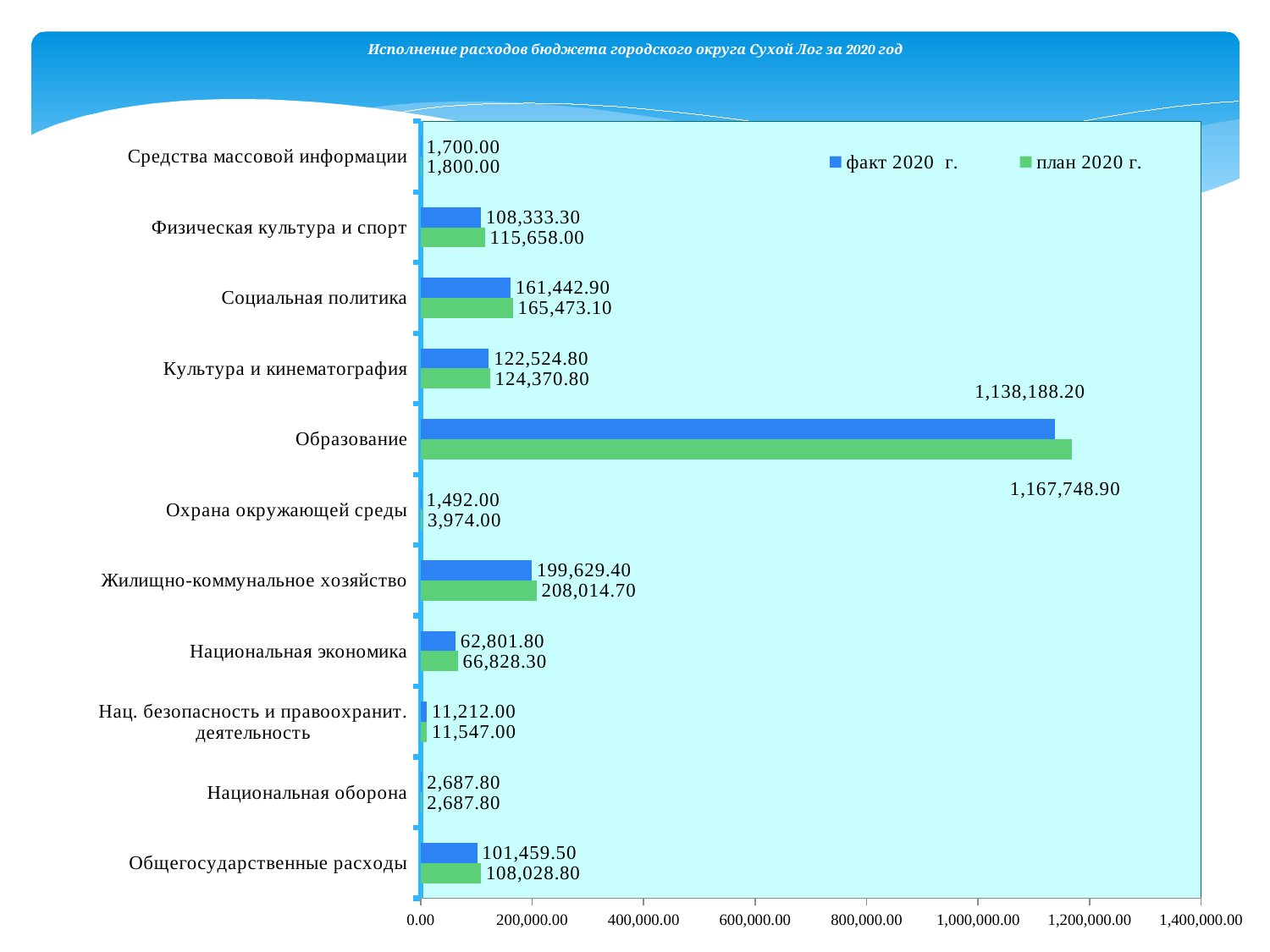
How many categories are shown on the chart? 11 What is the факт 2020 г. value for Национальная оборона? 2,687.80 Is the план 2020 г. value for Образование greater or less than 1,000,000.00? greater What is the difference between the план 2020 г. and факт 2020 г. values for Общегосударственные расходы? 6,569.30 Which category has the highest факт 2020 г. value? Образование Which category has the lowest план 2020 г. value? Средства массовой информации What is the план 2020 г. value for Жилищно-коммунальное хозяйство? 208,014.70 What kind of chart is shown on the slide? bar chart How many series does the legend list? 2 What is the difference between the план 2020 г. and факт 2020 г. values for Социальная политика? 4,030.20 Which has the larger факт 2020 г. value: Национальная экономика or Физическая культура и спорт? Физическая культура и спорт What is the факт 2020 г. value for Образование? 1,138,188.20